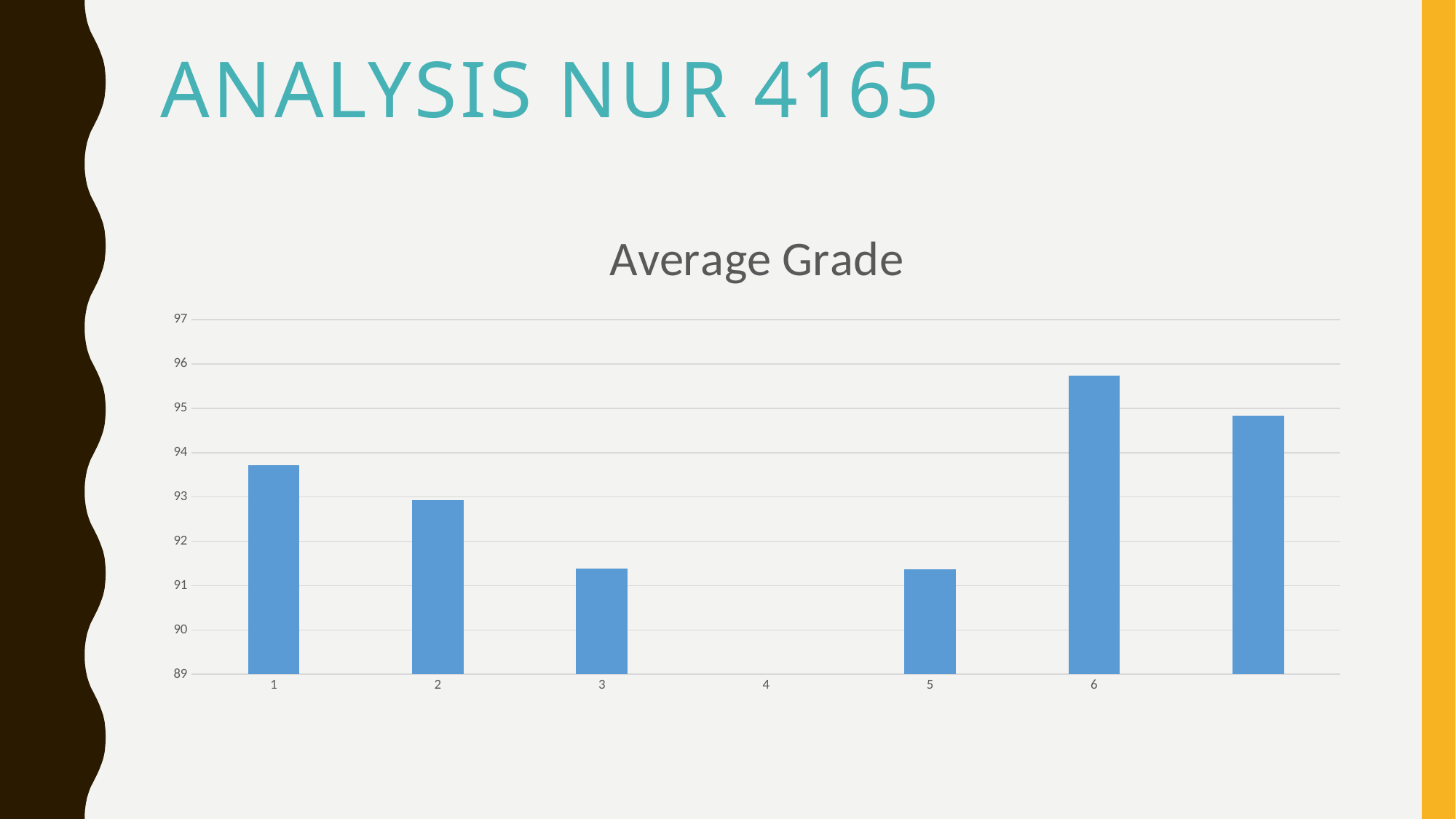
Is the value for category 5 greater or less than 91? greater What kind of chart is shown on the slide? bar chart What is the title of the chart? Average Grade Which is larger, the value for category 1 or category 2? category 1 Is the value for category 6 greater or less than 95? greater Is the value for category 3 greater or less than 92? less Which labeled category on the x axis has no bar plotted? 4 Which category has the highest average grade? 6 Which is larger, the value for category 6 or category 1? category 6